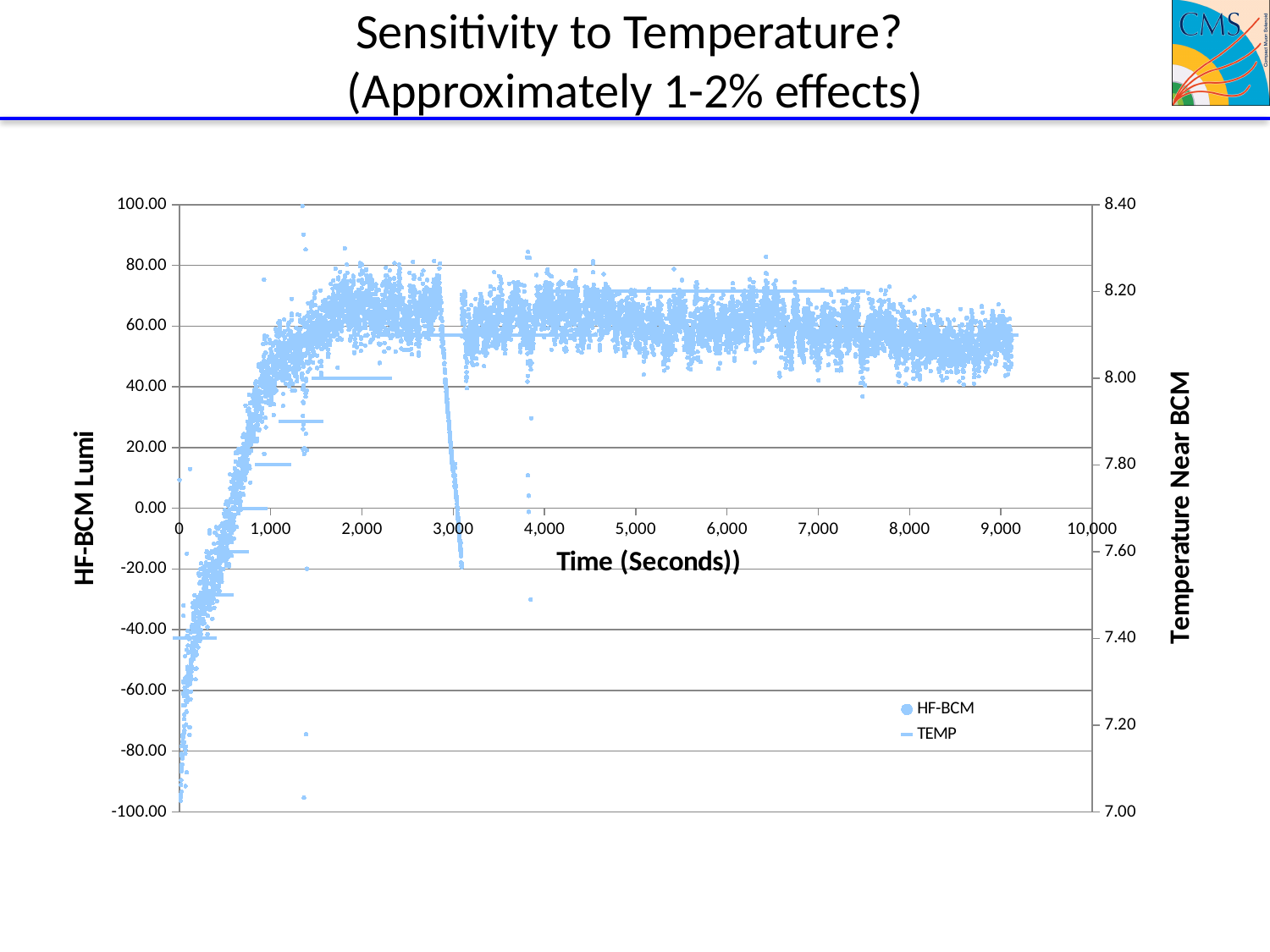
What is the title of the left vertical axis? HF-BCM Lumi What are the two series named in the legend? HF-BCM and TEMP Is the TEMP value at the start (time 0) greater or less than 7.60 on the right axis? less Is the TEMP value at around 5,000 seconds greater or less than 8.00 on the right axis? greater What is the highest value shown on the right vertical axis (Temperature Near BCM)? 8.40 What kind of chart is shown on the slide? scatter chart What is the largest tick value on the x axis (Time)? 10,000 Is the HF-BCM value at around 5,000 seconds greater or less than 40.00? greater How many series does the legend list? 2 What is the lowest value shown on the left vertical axis? -100.00 Do the HF-BCM values rise or fall between time 0 and time 1,000 seconds? rise